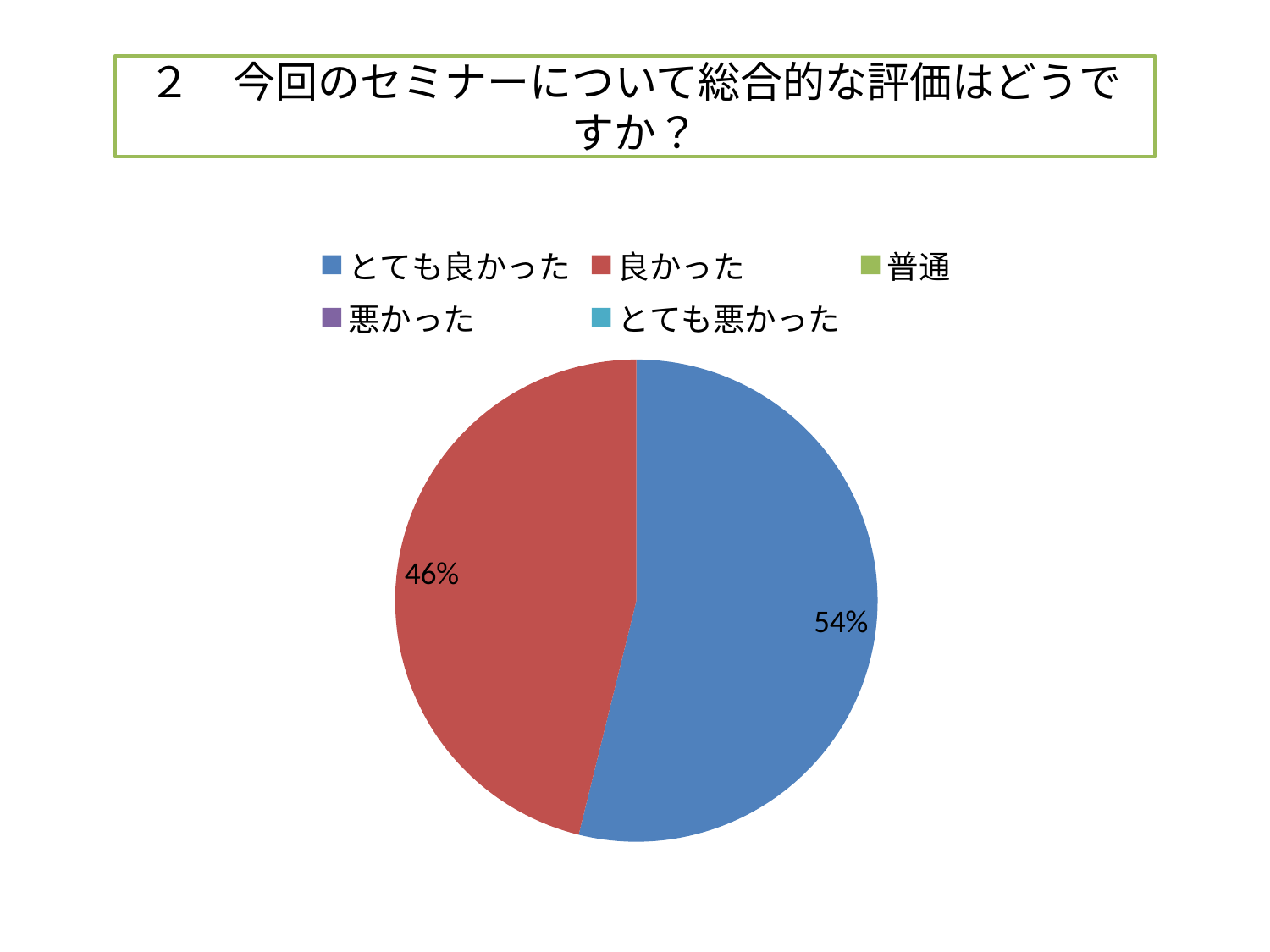
What colour is the slice for 良かった? red Which of the two visible slices is smaller, とても良かった or 良かった? 良かった What colour is the slice for とても良かった? blue What kind of chart is shown on the slide? pie chart What is the difference in percentage points between the とても良かった slice and the 良かった slice? 8 Which is larger, the share for とても良かった or the share for 良かった? とても良かった How many categories does the legend list? 5 What share of the pie does 良かった have? 46% What share of the pie does とても良かった have? 54% How many slices are visible in the pie? 2 Which category has the largest slice of the pie? とても良かった